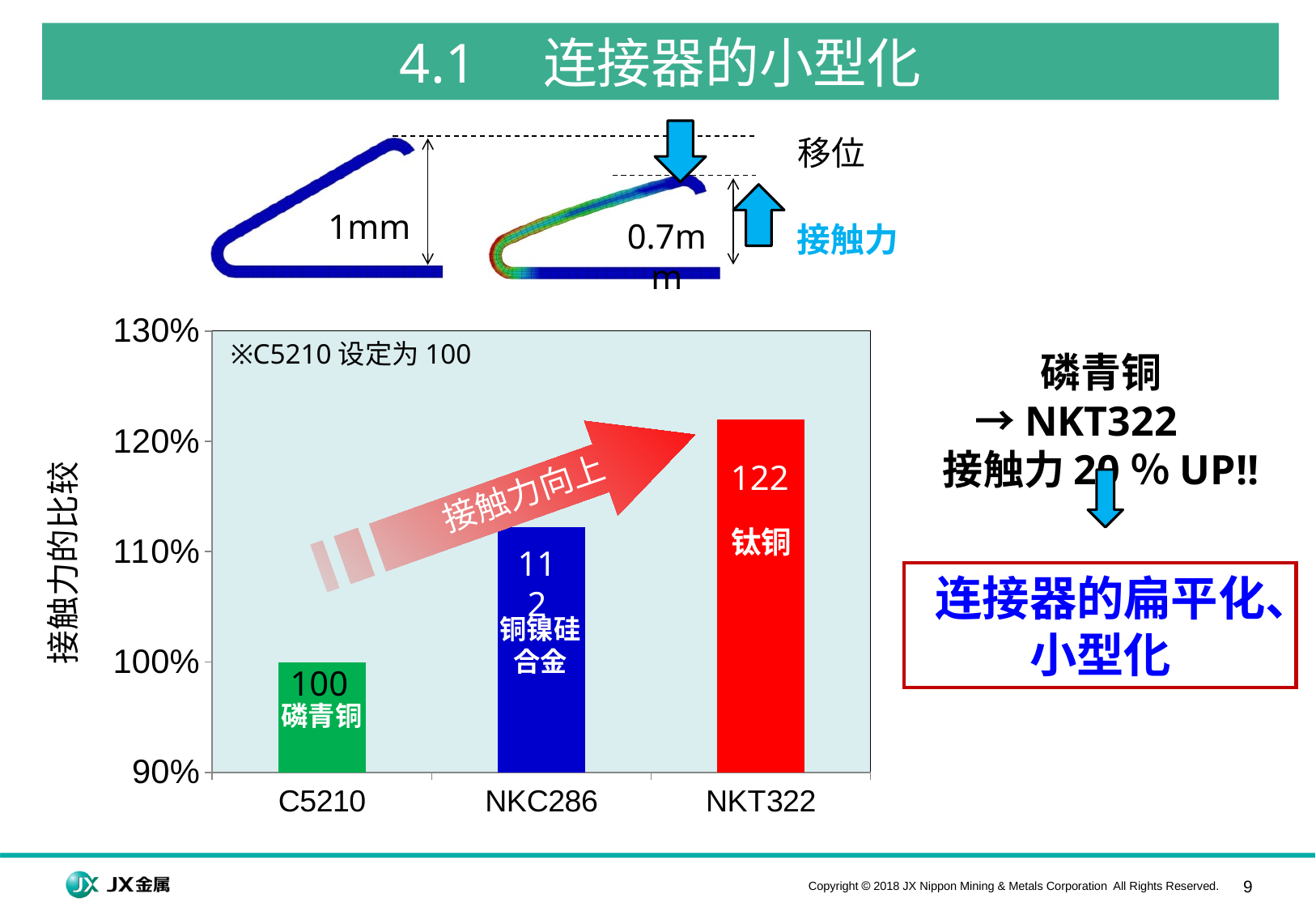
What is the value shown for NKC286? 112 What is the value shown for NKT322? 122 What kind of chart is shown on the slide? bar chart Do the bar values rise or fall from left to right along the x axis? rise Which category has the lowest bar? C5210 What is the difference between the values for NKT322 and C5210? 22 What is the difference between the values for NKC286 and C5210? 12 What is the value shown for C5210? 100 Which is larger, the value for NKC286 or the value for NKT322? NKT322 Which category has the highest bar? NKT322 How many categories are shown on the x axis? 3 Is the value for NKT322 greater or less than 120%? greater